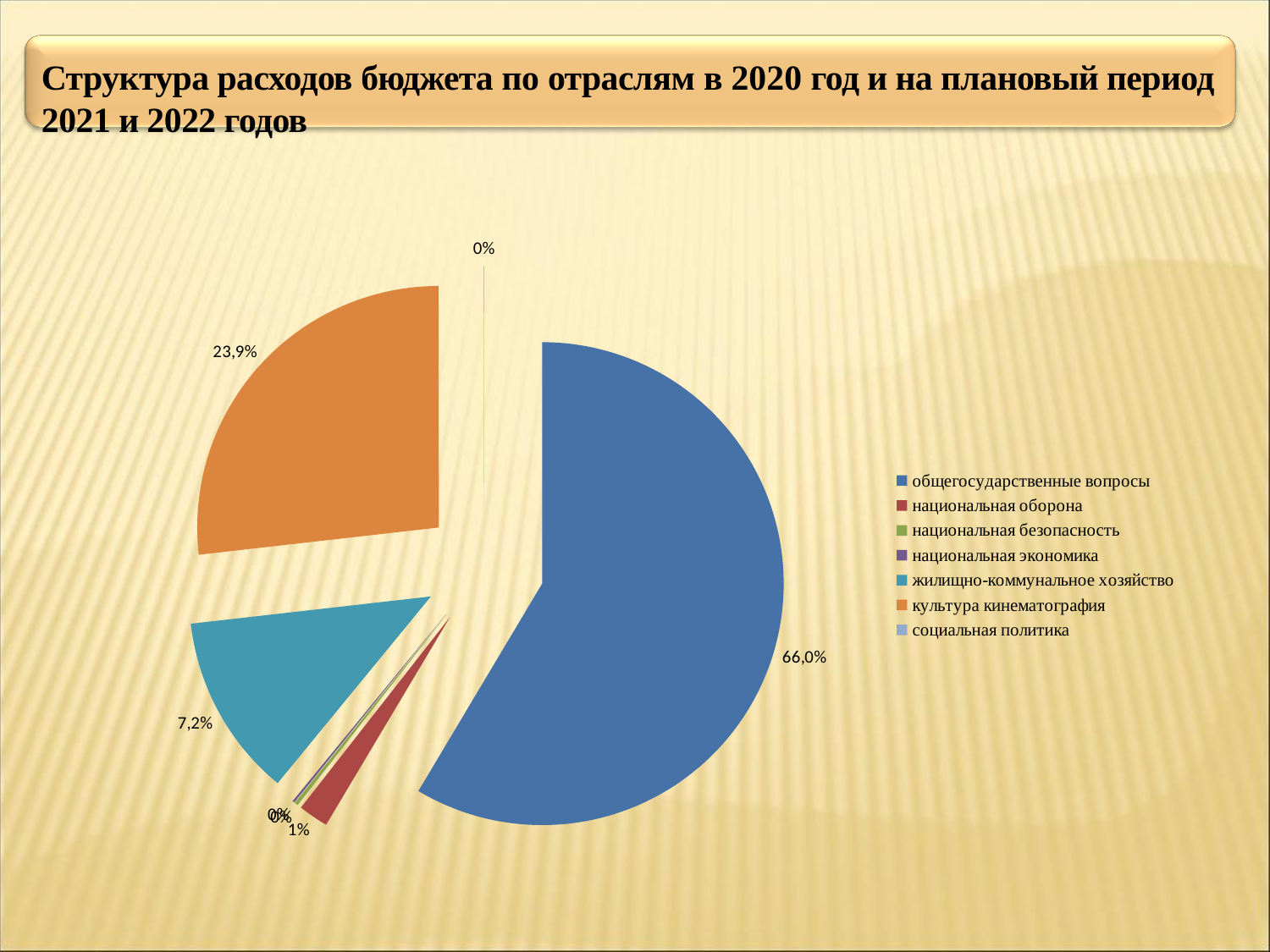
What is the value shown for национальная оборона? 1% What is the value shown for культура кинематография? 23,9% What share of the pie does общегосударственные вопросы take? 66,0% What colour is the slice for культура кинематография? orange What is the value shown for жилищно-коммунальное хозяйство? 7,2% What is the difference between the shares of культура кинематография and жилищно-коммунальное хозяйство? 16,7% What is the difference between the shares of общегосударственные вопросы and культура кинематография? 42,1% What kind of chart is shown on the slide? pie chart Which category has the largest slice of the pie? общегосударственные вопросы Which is larger, культура кинематография or жилищно-коммунальное хозяйство? культура кинематография How many categories does the legend list? 7 What colour is the slice for общегосударственные вопросы? blue